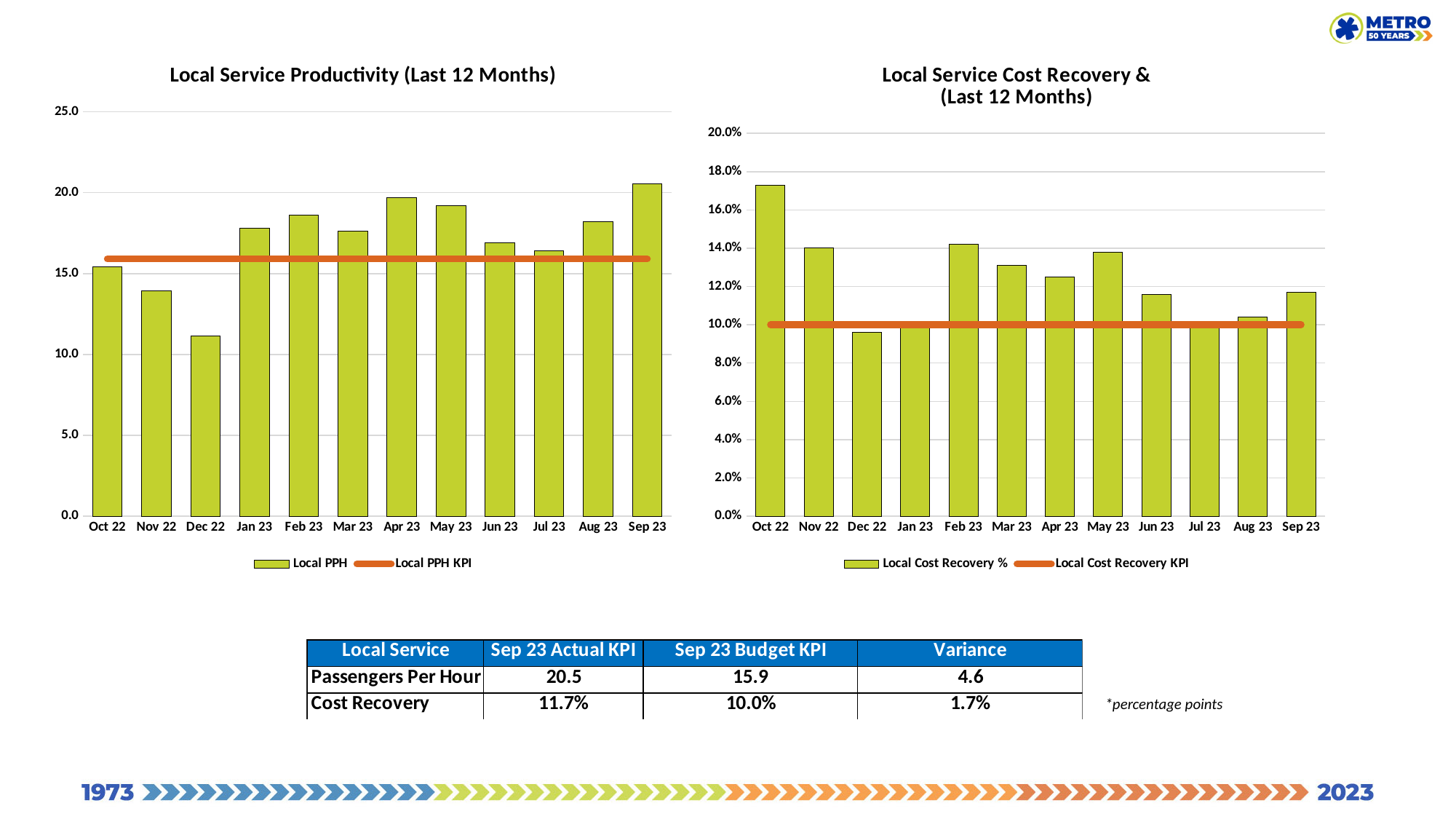
In the Local Service Productivity (Last 12 Months) chart, is the Local PPH value for Apr 23 greater or less than 15.0? greater In the Local Service Productivity (Last 12 Months) chart, which month has the highest Local PPH? Sep 23 What is the name of the line series in the legend of the Local Service Cost Recovery & (Last 12 Months) chart? Local Cost Recovery KPI What kind of chart is the Local Service Productivity (Last 12 Months) chart? bar chart How many months are plotted in the Local Service Productivity (Last 12 Months) chart? 12 In the Local Service Cost Recovery & (Last 12 Months) chart, is the Local Cost Recovery % for Oct 22 greater or less than 16.0%? greater In the Local Service Productivity (Last 12 Months) chart, which month has the lowest Local PPH? Dec 22 How many series does the legend of the Local Service Productivity (Last 12 Months) chart list? 2 In the Local Service Productivity (Last 12 Months) chart, do the Local PPH values rise or fall from Oct 22 to Dec 22? fall In the Local Service Cost Recovery & (Last 12 Months) chart, which month has the highest Local Cost Recovery %? Oct 22 In the Local Service Productivity (Last 12 Months) chart, is the Local PPH value for Dec 22 greater or less than 15.0? less In the Local Service Cost Recovery & (Last 12 Months) chart, which is larger, the Local Cost Recovery % for Feb 23 or for Mar 23? Feb 23